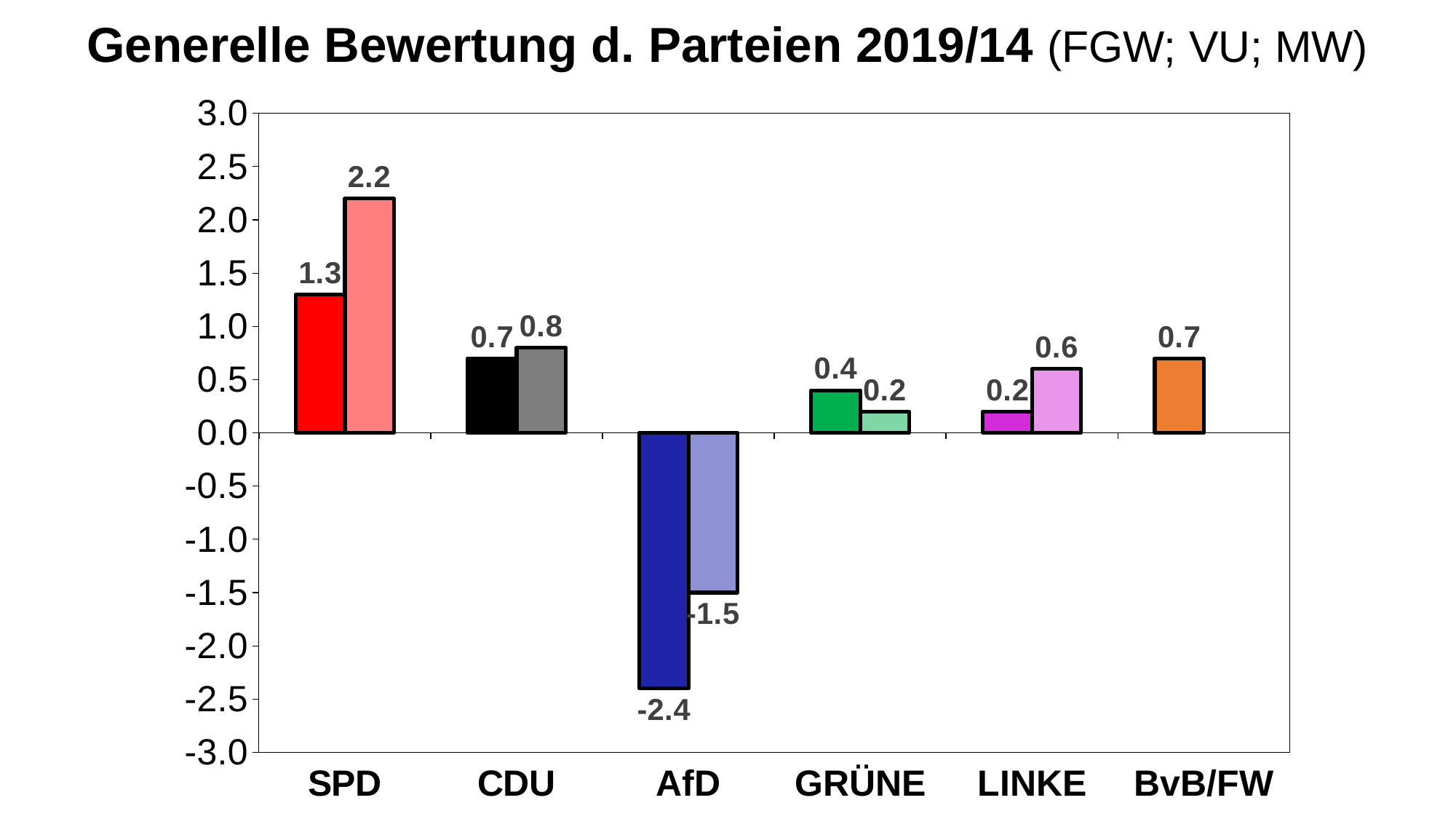
What kind of chart is shown on the slide? Bar chart What is the value of the right (second) bar for CDU? 0.8 Which party has the highest value on the chart? SPD What is the value shown for BvB/FW? 0.7 How many parties have negative values on the chart? 1 Which is larger: the left bar for GRÜNE or the left bar for LINKE? GRÜNE How many parties are shown on the x axis? 6 What is the value of the left (first) bar for AfD? -2.4 Which party has the lowest value on the chart? AfD What is the value of the left (first) bar for SPD? 1.3 What is the difference between the two SPD bars (2.2 and 1.3)? 0.9 What is the value of the right (second) bar for SPD? 2.2